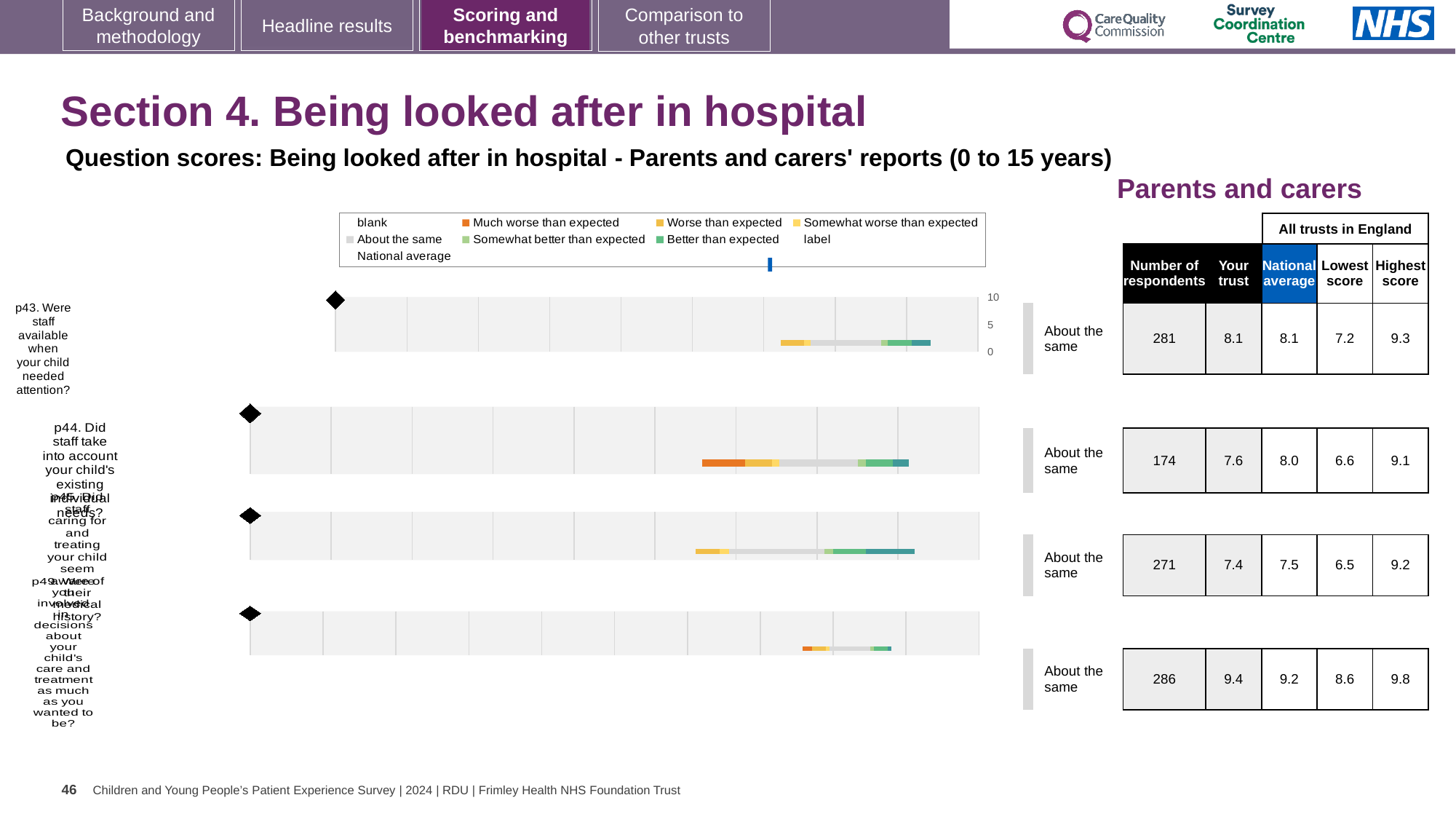
Which question has the highest 'Your trust' score on this slide? p49 What kind of chart is used to show each question score? Bar chart How many respondents are shown for p43 (Were staff available when your child needed attention?)? 281 What benchmark category is shown for p44 (Did staff take into account your child's existing individual needs?)? About the same For p45, what is the difference between the highest score and the lowest score among all trusts in England? 2.7 What is the highest score among all trusts in England for p49 (Were you involved in decisions about your child's care and treatment as much as you wanted to be?)? 9.8 What is the 'Your trust' score for p44 (Did staff take into account your child's existing individual needs?)? 7.6 For p49, which is larger: the 'Your trust' score or the national average? Your trust Which question has the lowest 'Your trust' score on this slide? p45 What is the national average score for p45 (Did staff caring for and treating your child seem aware of their medical history?)? 7.5 How many question charts are shown on this slide? 4 For p44, how much higher is the national average than the 'Your trust' score? 0.4